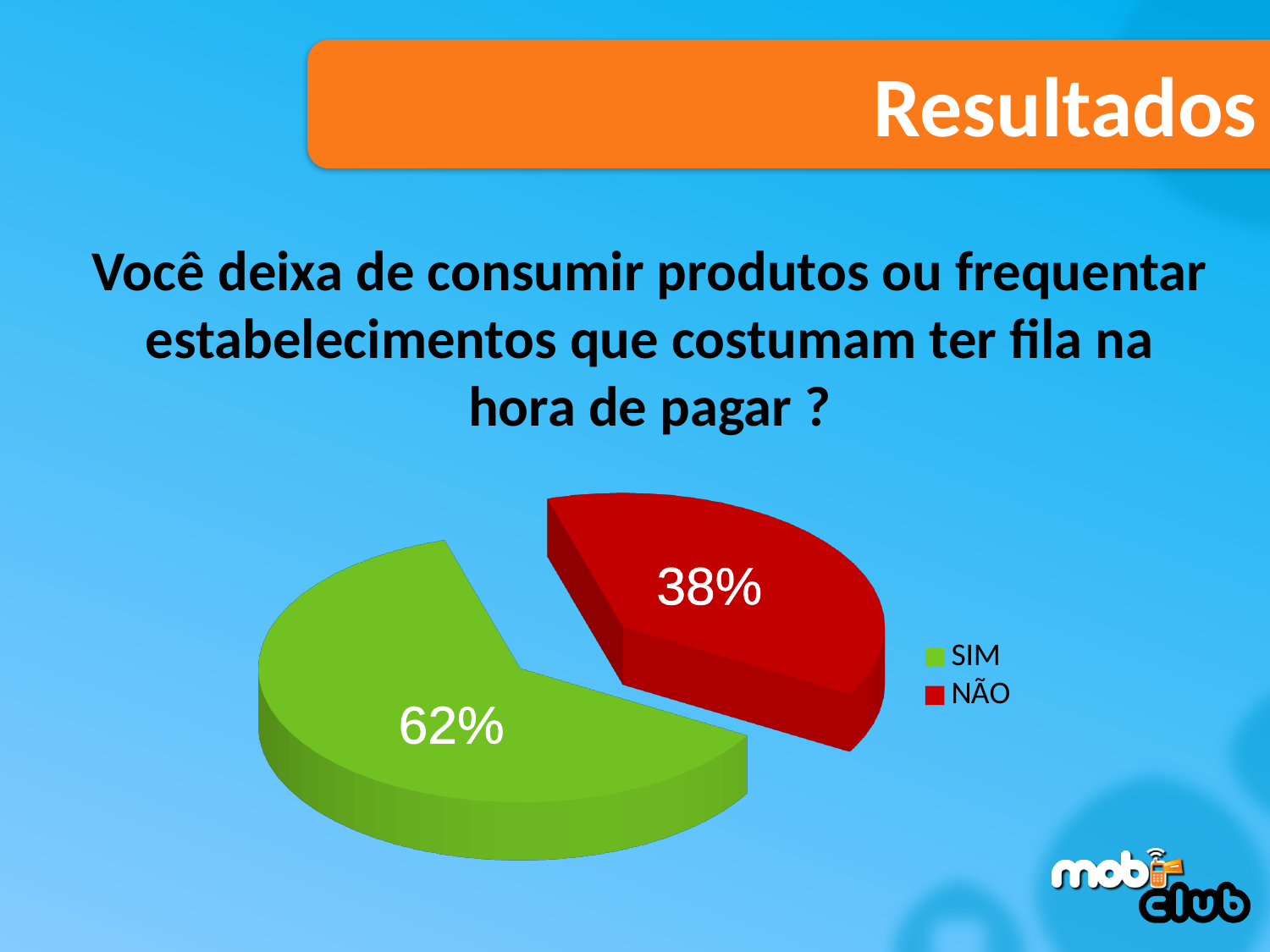
How many slices does the pie chart have? 2 What percentage of respondents answered NÃO? 38% Which slice is larger, SIM or NÃO? SIM What colour is the NÃO slice? red Which response has the largest share of the pie? SIM What is the difference in percentage points between the SIM and NÃO slices? 24 What share of the pie does the NÃO slice represent? 38% What colour is the SIM slice? green Which response has the smallest share of the pie? NÃO What percentage of respondents answered SIM? 62% How many entries does the legend list? 2 What kind of chart is shown on the slide? pie chart